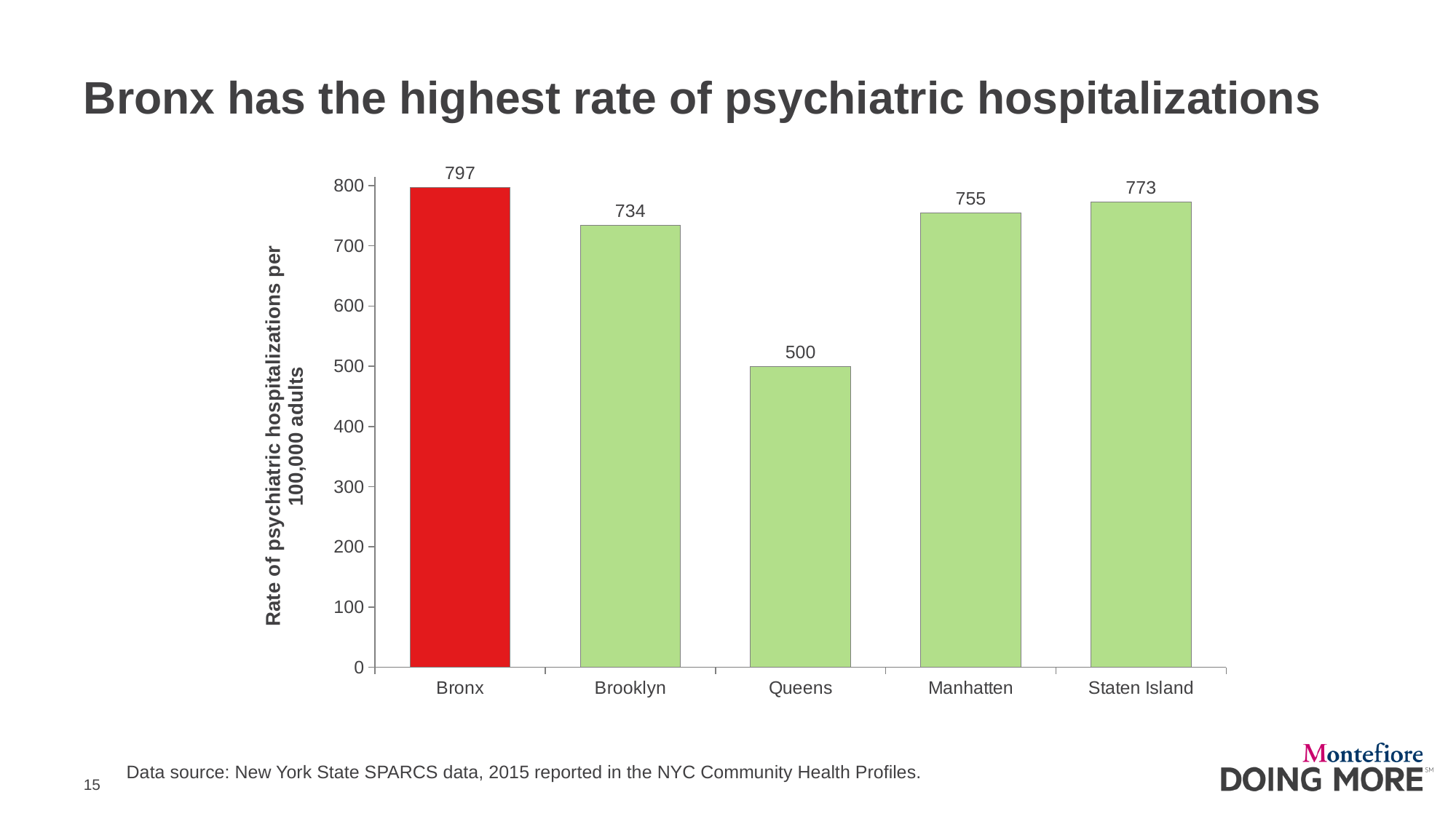
What is the difference between the Bronx rate and the Queens rate? 297 Which has a higher rate of psychiatric hospitalizations, Manhattan or Brooklyn? Manhattan What is the rate of psychiatric hospitalizations per 100,000 adults for Staten Island? 773 Which bar is coloured red rather than green? Bronx Which borough has the lowest rate of psychiatric hospitalizations? Queens Is the value for Queens greater or less than 600? less Which borough has the highest rate of psychiatric hospitalizations? Bronx What is the rate of psychiatric hospitalizations per 100,000 adults for the Bronx? 797 What kind of chart is shown on the slide? Bar chart What is the difference between the Staten Island rate and the Brooklyn rate? 39 How many boroughs are shown on the chart? 5 What is the rate of psychiatric hospitalizations per 100,000 adults for Queens? 500